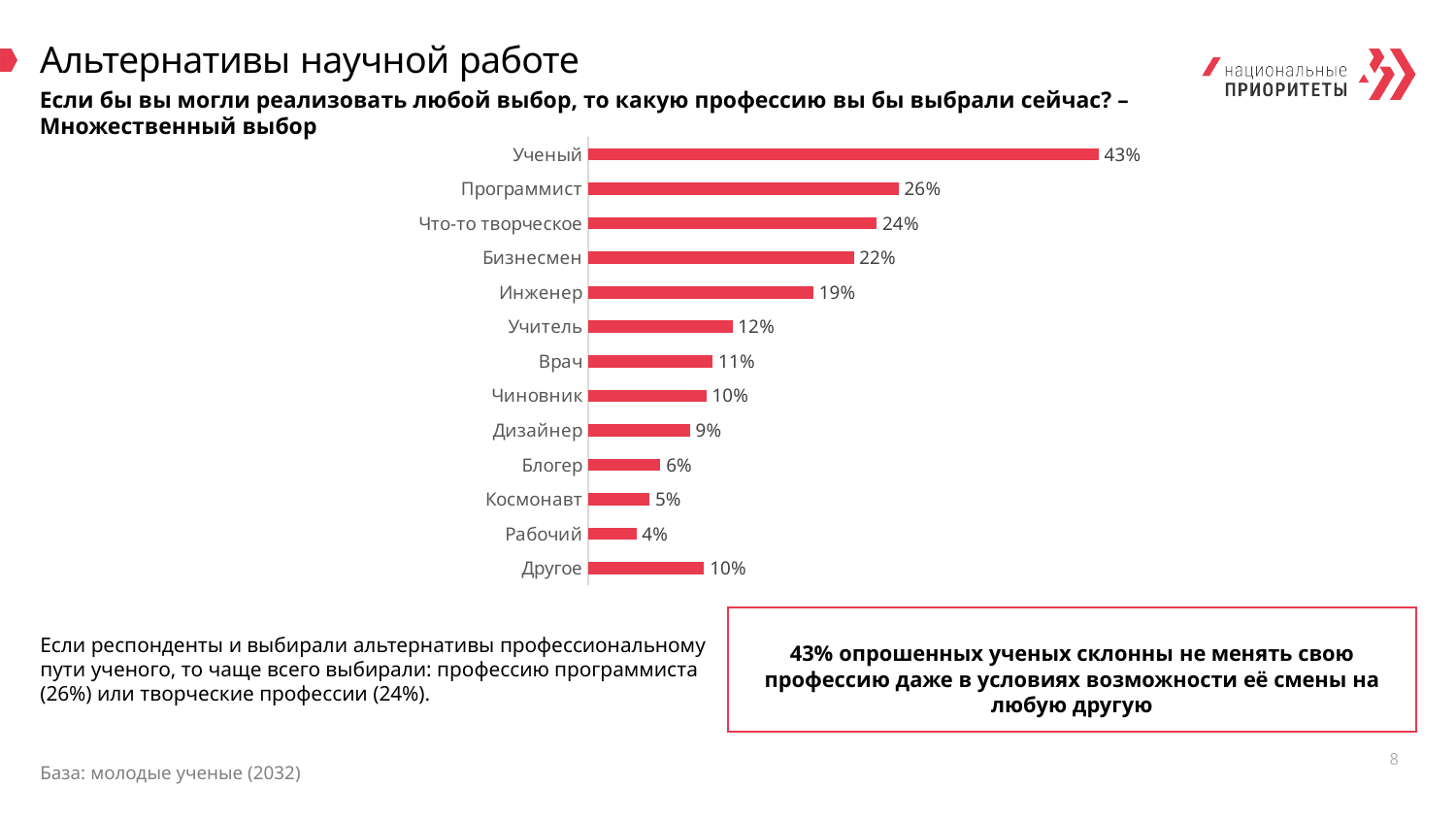
Which category has the highest value? Ученый Which is larger, the value for Что-то творческое or the value for Бизнесмен? Что-то творческое What is the value for Ученый? 43% What colour are the bars in the chart? Red What kind of chart is shown on the slide? Bar chart What is the difference between the values for Бизнесмен and Учитель? 10% What is the value for Программист? 26% What is the difference between the values for Ученый and Программист? 17% Which category has the lowest value? Рабочий How many categories are shown in the chart? 13 What is the value for Космонавт? 5% What is the value for Инженер? 19%